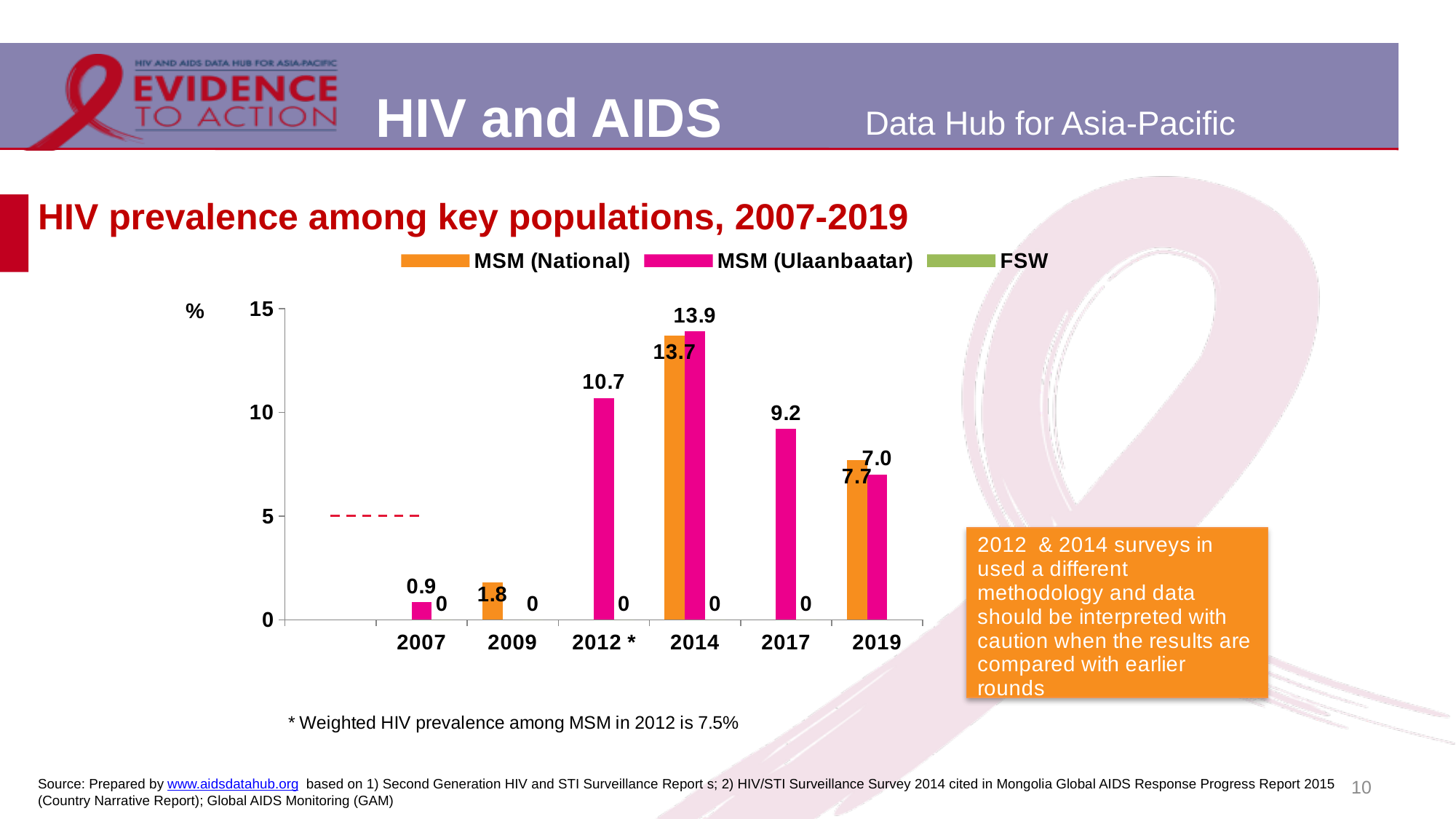
What is the HIV prevalence among MSM (Ulaanbaatar) in 2017? 9.2 How many years are shown on the x axis of the chart? 6 How many series does the legend list? 3 What is the HIV prevalence among MSM (National) in 2009? 1.8 What is the HIV prevalence among MSM (National) in 2014? 13.7 Is the MSM (Ulaanbaatar) value for 2017 greater or less than 10? less In which year is the HIV prevalence among MSM (Ulaanbaatar) highest? 2014 In 2019, which is larger: MSM (National) or MSM (Ulaanbaatar)? MSM (National) In 2014, how much higher is the MSM (Ulaanbaatar) value than the MSM (National) value? 0.2 What kind of chart is shown on the slide? bar chart In which year is the HIV prevalence among MSM (Ulaanbaatar) lowest? 2007 What is the HIV prevalence among MSM (Ulaanbaatar) in 2012? 10.7